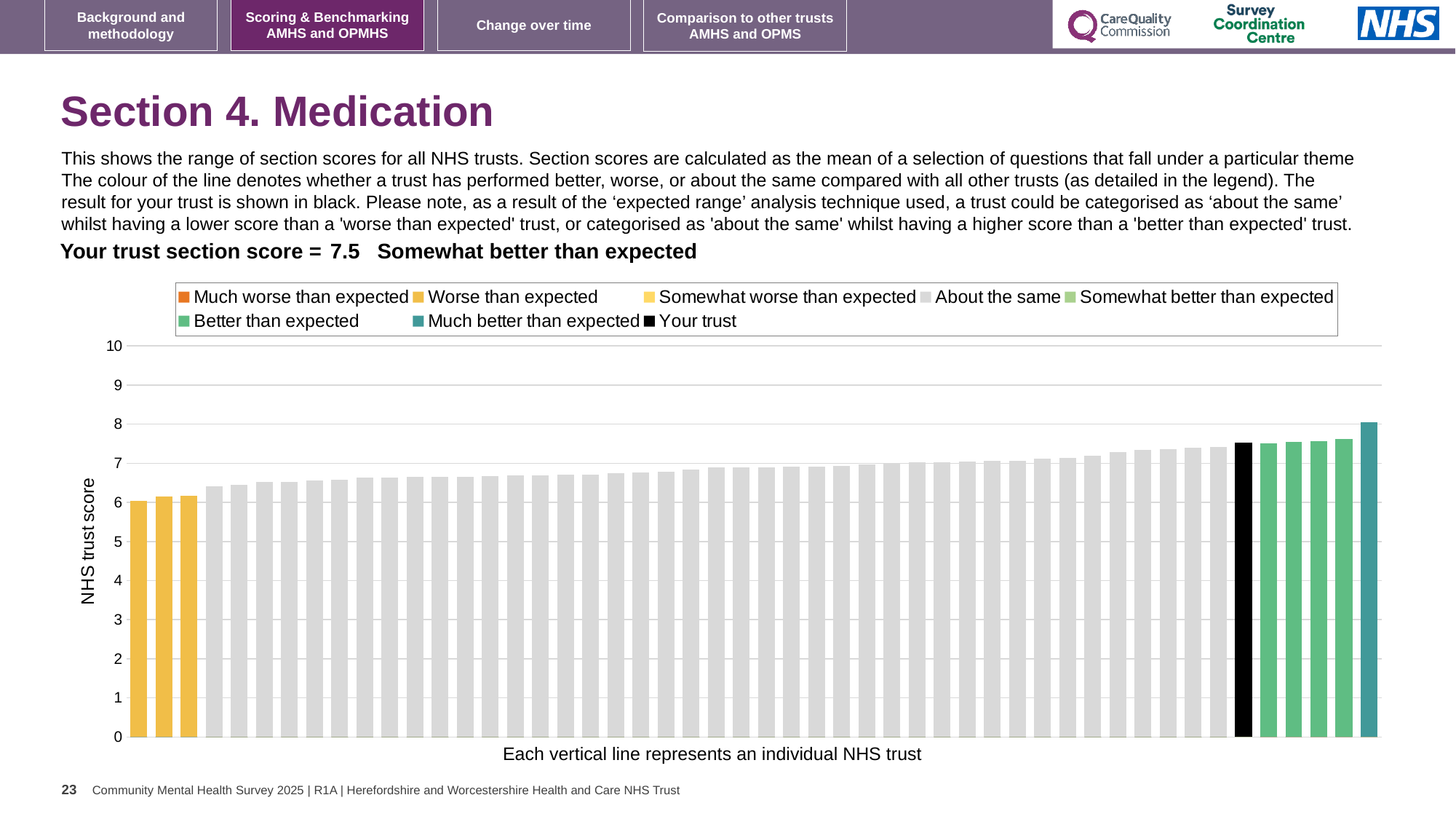
Which category is your trust's section score placed in? Somewhat better than expected What is the section score for your trust? 7.5 How many bars are coloured as 'Better than expected' (green)? 4 How many bars are coloured as 'Much better than expected' (teal)? 1 What is the label on the vertical axis of the chart? NHS trust score What kind of chart is shown on the slide? bar chart How many entries does the chart legend list? 8 Is the value of the rightmost bar greater or less than 9? less Do the bar values rise or fall from left to right across the chart? rise Is the value of the black 'Your trust' bar greater or less than 7? greater Which is larger, the value of the black 'Your trust' bar or the value of the leftmost bar? Your trust Is the value of the leftmost bar greater or less than 5? greater